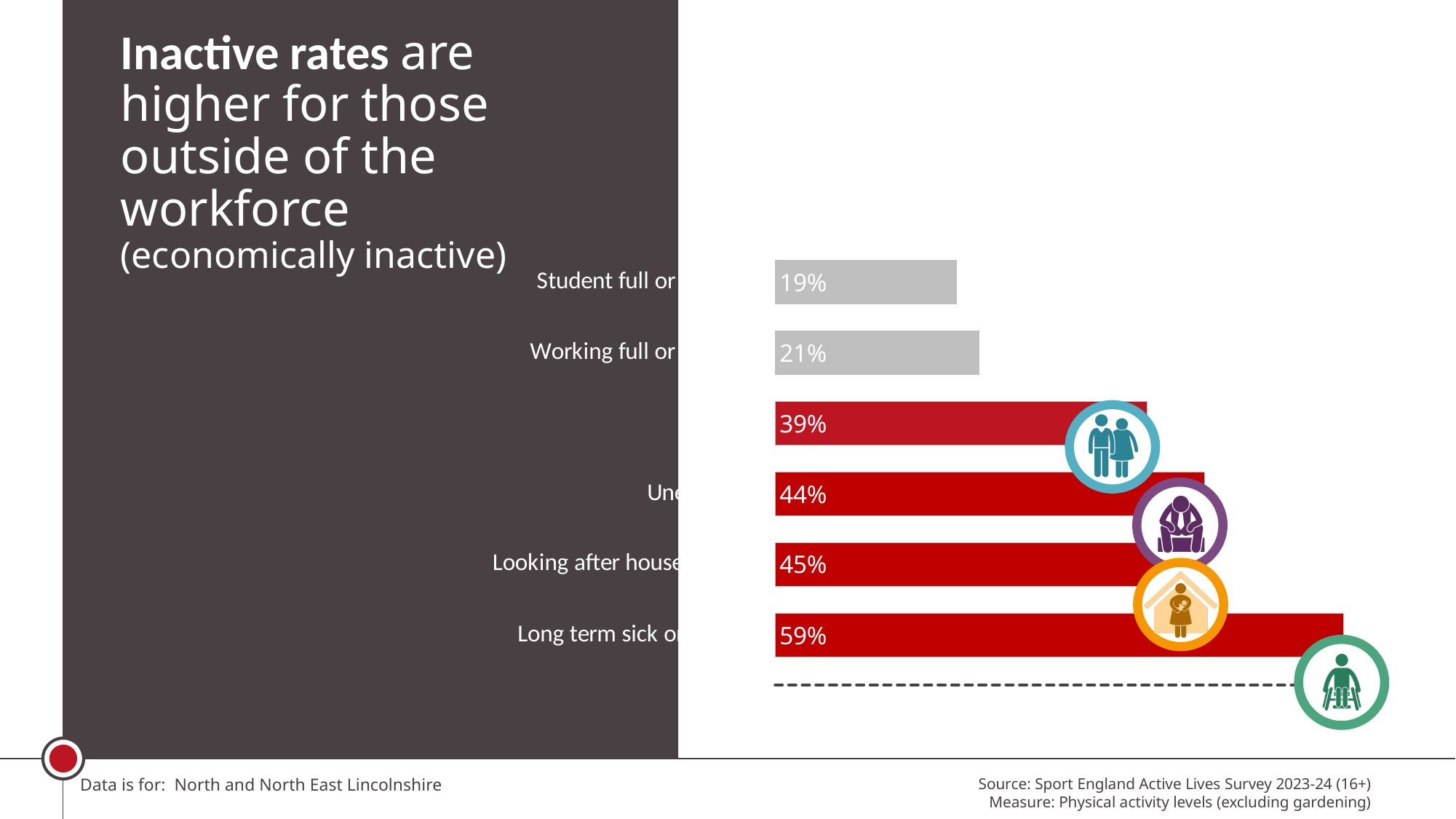
What is the value for the 'Working full or...' category? 21% What is the value for the 'Looking after house...' category? 45% Which category has the highest value in the chart? Long term sick or... What is the difference between the values for 'Long term sick or...' and 'Student full or...'? 40% What is the value for the 'Student full or...' category? 19% What colour are the two bars with the lowest values? grey How many bars are plotted in the chart? 6 What kind of chart is shown on the slide? bar chart Which category has the lowest value in the chart? Student full or... What is the value for the 'Long term sick or...' category? 59% Which is larger, the value for 'Working full or...' or the value for 'Looking after house...'? Looking after house... What is the difference between the values for 'Working full or...' and 'Student full or...'? 2%